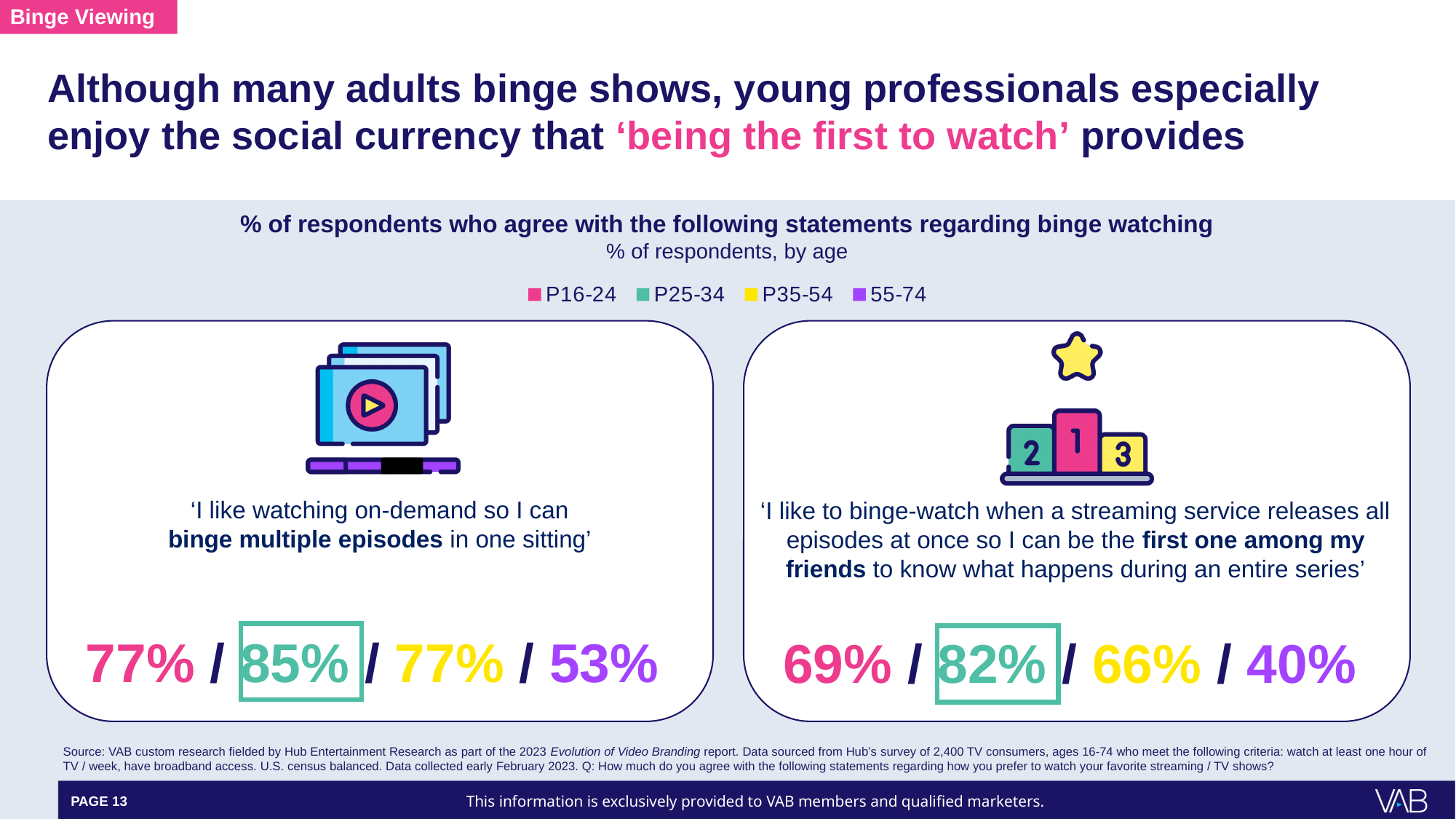
In the left panel, what is the difference between the P25-34 value and the 55-74 value? 32 percentage points Which is larger: the P25-34 value in the left panel or the P25-34 value in the right panel? Left panel (85%) What colour is used for the P35-54 age group in the legend? Yellow In the left panel ('binge multiple episodes in one sitting'), what percentage of P25-34 respondents agree? 85% In the right panel, is the value for P35-54 greater or less than 50%? greater In the right panel ('first one among my friends'), what percentage of 55-74 respondents agree? 40% In the right panel, what is the difference between the P16-24 value and the P35-54 value? 3 percentage points In the left panel, which two age groups share the same value of 77%? P16-24 and P35-54 In the left panel ('binge multiple episodes in one sitting'), which age group has the highest share of agreement? P25-34 In the right panel ('first one among my friends'), what percentage of P16-24 respondents agree? 69% In the right panel ('first one among my friends'), which age group has the lowest share of agreement? 55-74 How many age groups does the legend list? 4